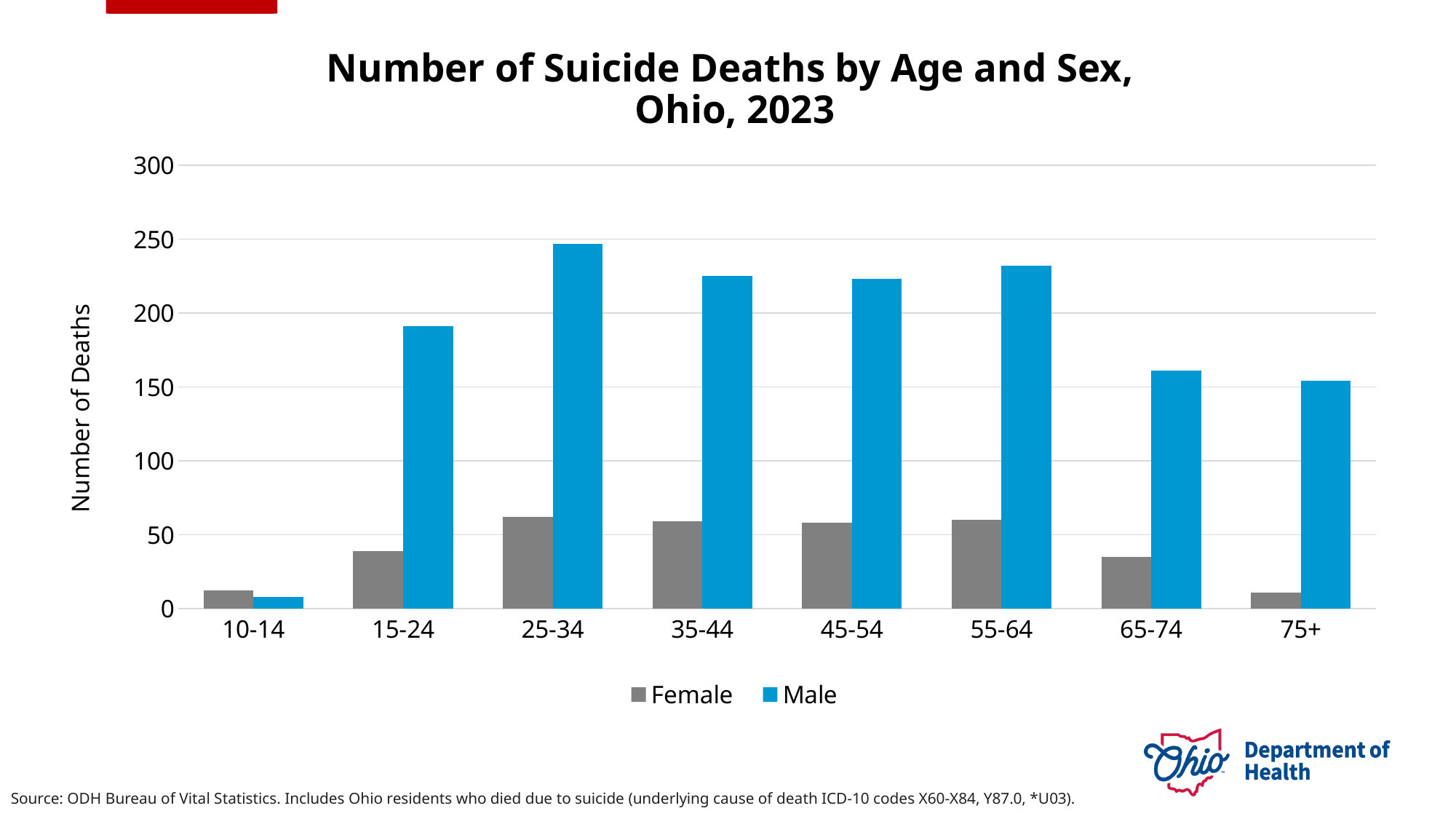
What type of chart is shown on the slide? bar chart Which age group has the highest number of male suicide deaths? 25-34 Which is larger, the number of male deaths for 15-24 or for 65-74? 15-24 How many series does the legend list? 2 In the 10-14 age group, which series has the larger value, Female or Male? Female Is the number of male deaths for the 25-34 age group greater or less than 200? greater Is the number of female deaths for the 15-24 age group greater or less than 50? less How many age groups are shown on the x axis? 8 Is the number of male deaths for the 15-24 age group greater or less than 200? less Which age group has the lowest number of male suicide deaths? 10-14 What is the label of the y axis? Number of Deaths